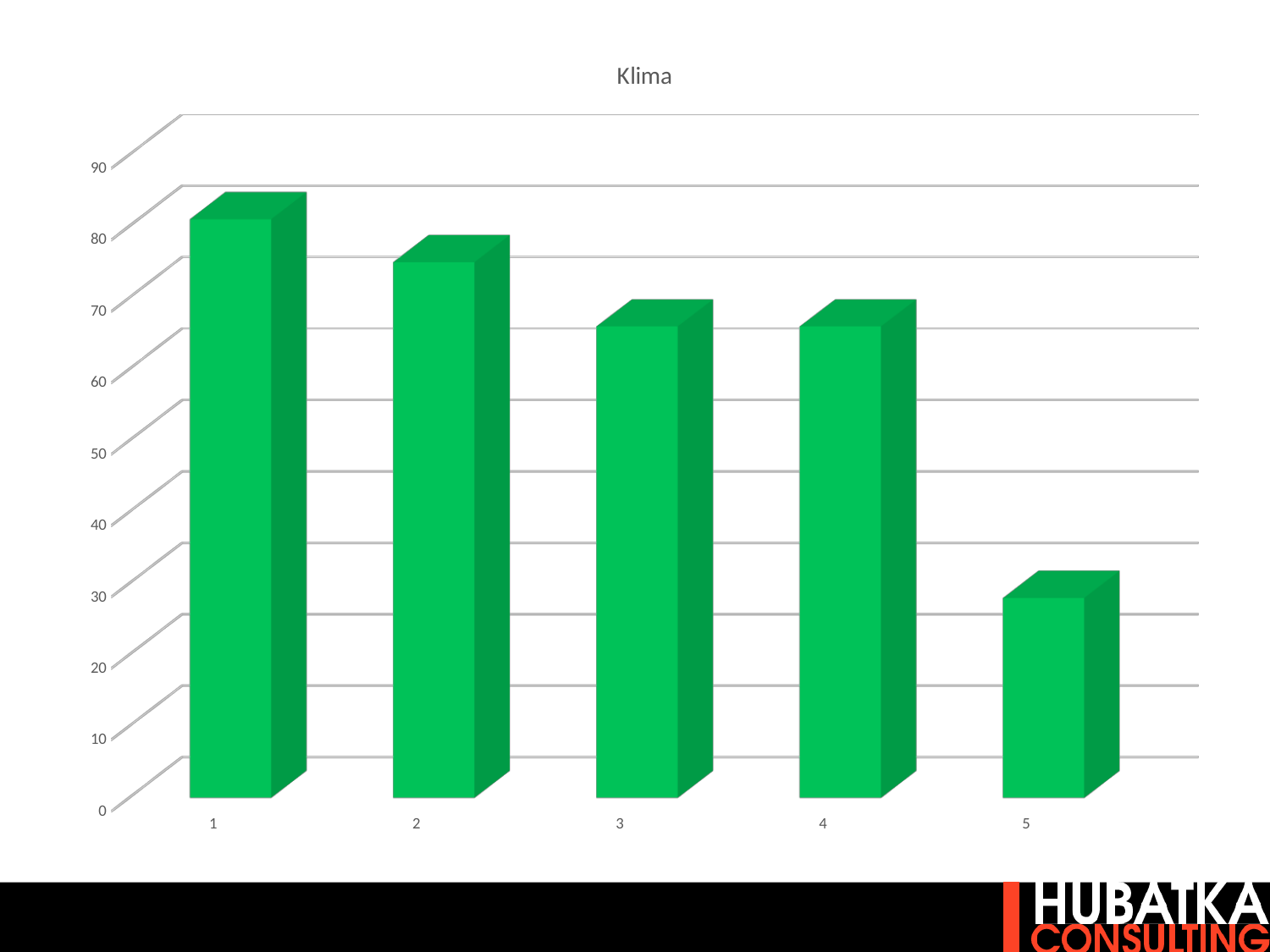
Is the value for category 3 greater or less than 60? greater Is the value for category 2 greater or less than 70? greater Which is larger, the value for category 4 or the value for category 5? 4 How many categories are plotted on the x axis? 5 What kind of chart is shown on the slide? bar chart Is the value for category 5 greater or less than 40? less Which is larger, the value for category 1 or the value for category 2? 1 Which category has the highest value? 1 Which category has the lowest value? 5 Do the values generally rise or fall from category 1 to category 5? fall What is the title of the chart? Klima